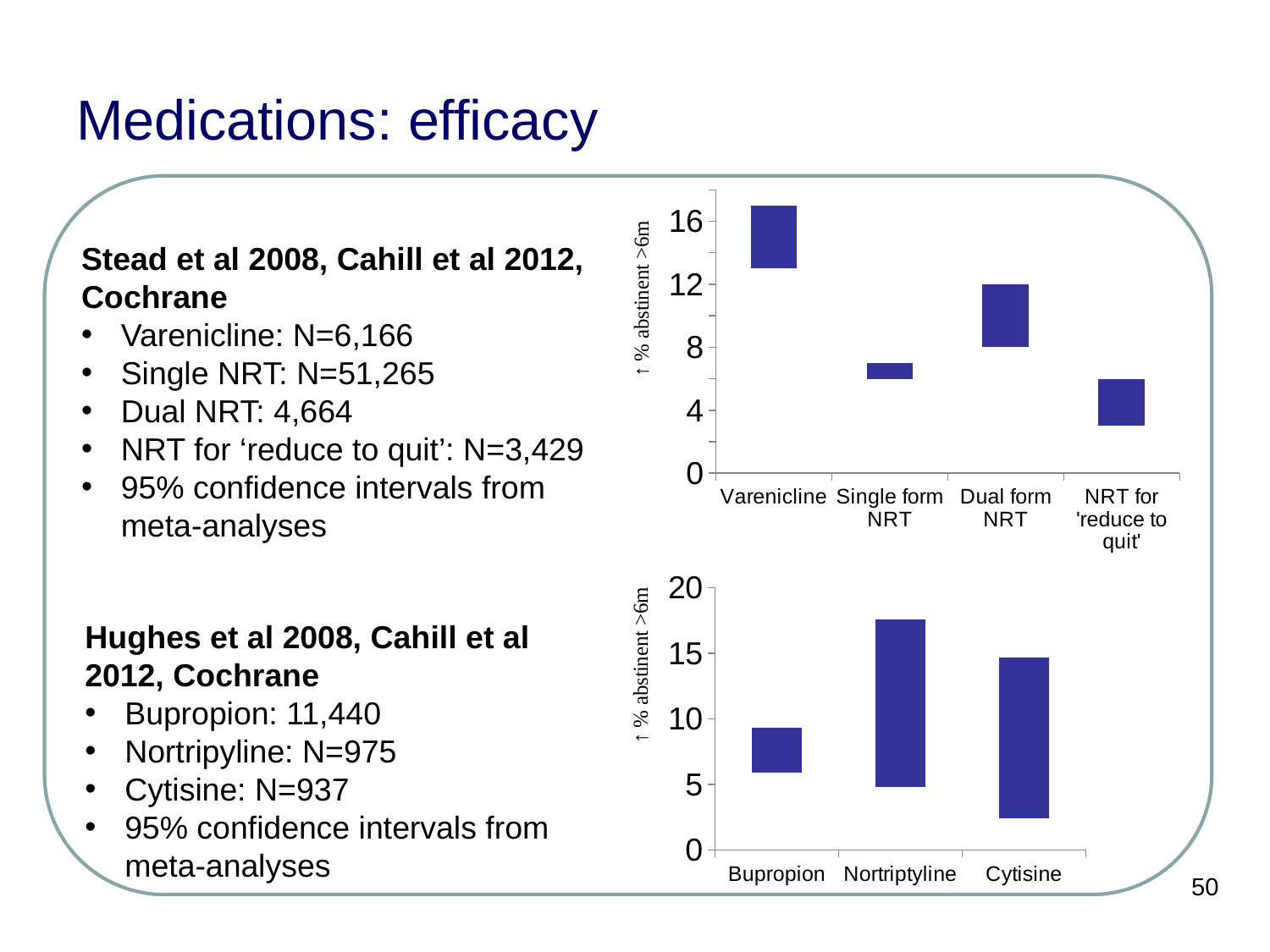
In the top chart, which category's bar reaches the highest value? Varenicline In the bottom chart, which category's bar reaches the highest value? Nortriptyline In the bottom chart, is the upper end of the bar for Nortriptyline greater or less than 15? greater In the top chart, how many medication categories are shown on the x axis? 4 In the bottom chart, is the upper end of the bar for Bupropion greater or less than 10? less In the bottom chart, which category's bar extends to the lowest value? Cytisine In the bottom chart, how many medication categories are shown on the x axis? 3 What is the y-axis label on the top chart? ↑ % abstinent >6m In the top chart, is the upper end of the bar for Single form NRT greater or less than 8? less In the top chart, which category's bar extends to the lowest value? NRT for 'reduce to quit' What kind of chart is the top chart? bar chart